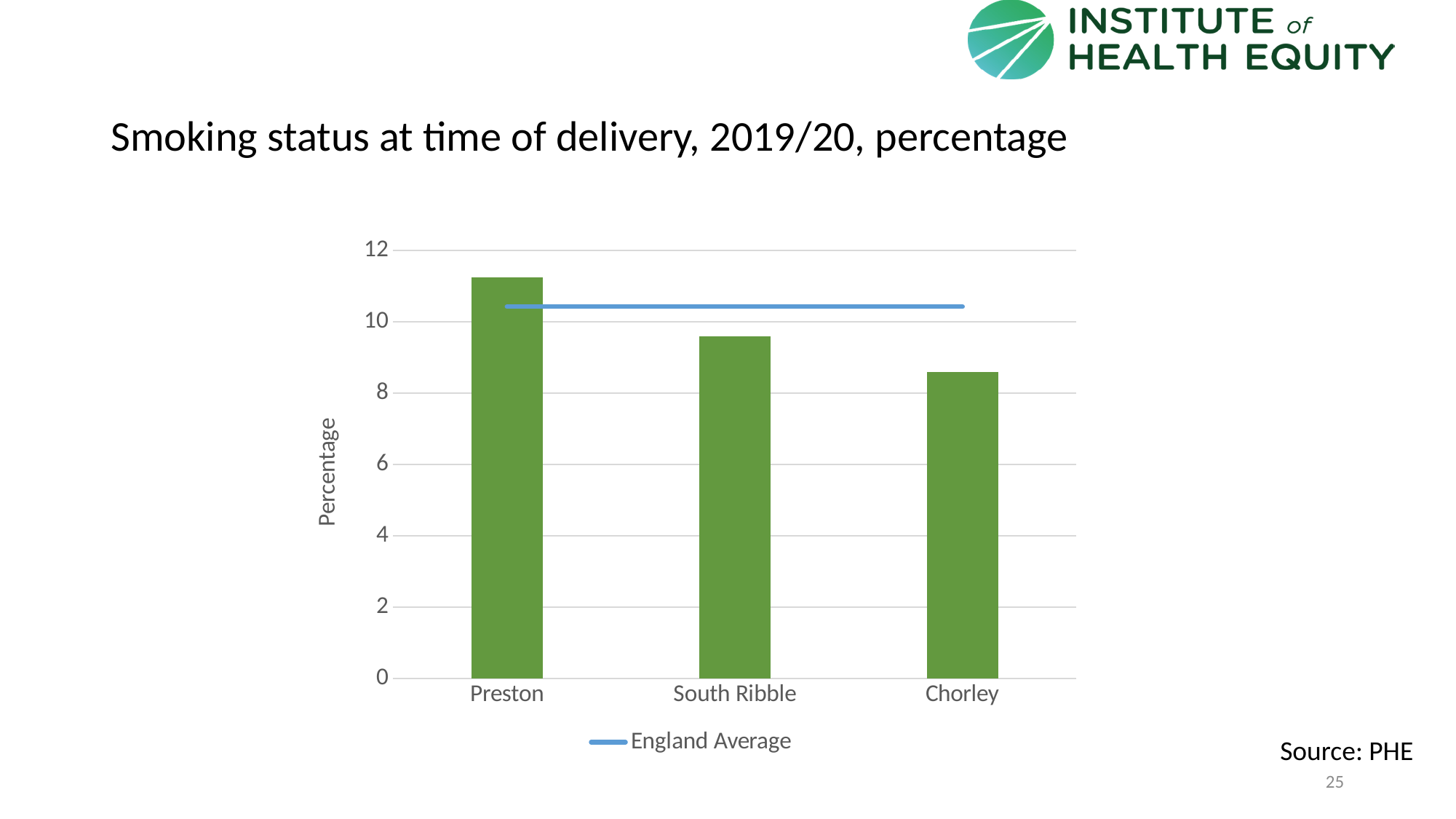
What is the label of the vertical axis? Percentage Is the value for South Ribble greater or less than 10? less Which area has the lowest smoking status at time of delivery percentage? Chorley What kind of chart is shown on the slide? bar chart Which area has the highest smoking status at time of delivery percentage? Preston Is the value for Chorley greater or less than 8? greater Is the value for Preston greater or less than 10? greater What does the blue horizontal line on the chart represent, according to the legend? England Average Which is larger, the value for South Ribble or the value for Chorley? South Ribble How many areas are shown on the x axis of the chart? 3 Do the bar values rise or fall from Preston to Chorley along the x axis? fall Is the value for Preston above or below the England Average line? above